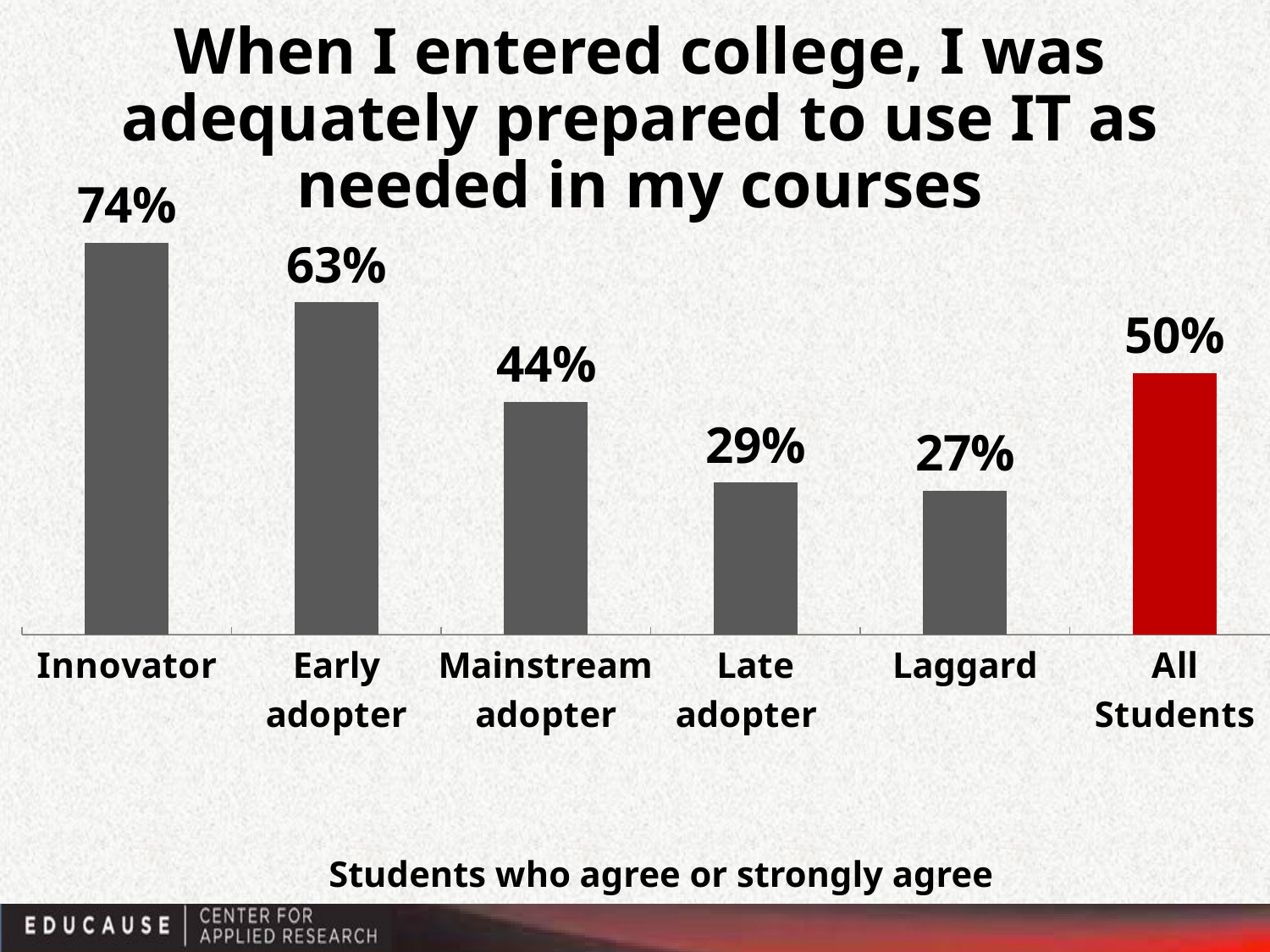
What is the difference between the Innovator value and the Laggard value? 47% Which category has the highest value? Innovator What is the value shown for All Students? 50% Do the values rise or fall from Innovator to Laggard along the x axis? Fall Which category has the lowest value? Laggard How many categories are shown on the x axis? 6 Which bar is coloured red rather than grey? All Students What is the difference between the Early adopter value and the Mainstream adopter value? 19% What percentage of Innovators agreed or strongly agreed that they were adequately prepared to use IT when they entered college? 74% What kind of chart is shown on the slide? Bar chart What is the value shown for Laggard? 27% Which is larger, the value for Mainstream adopter or the value for All Students? All Students